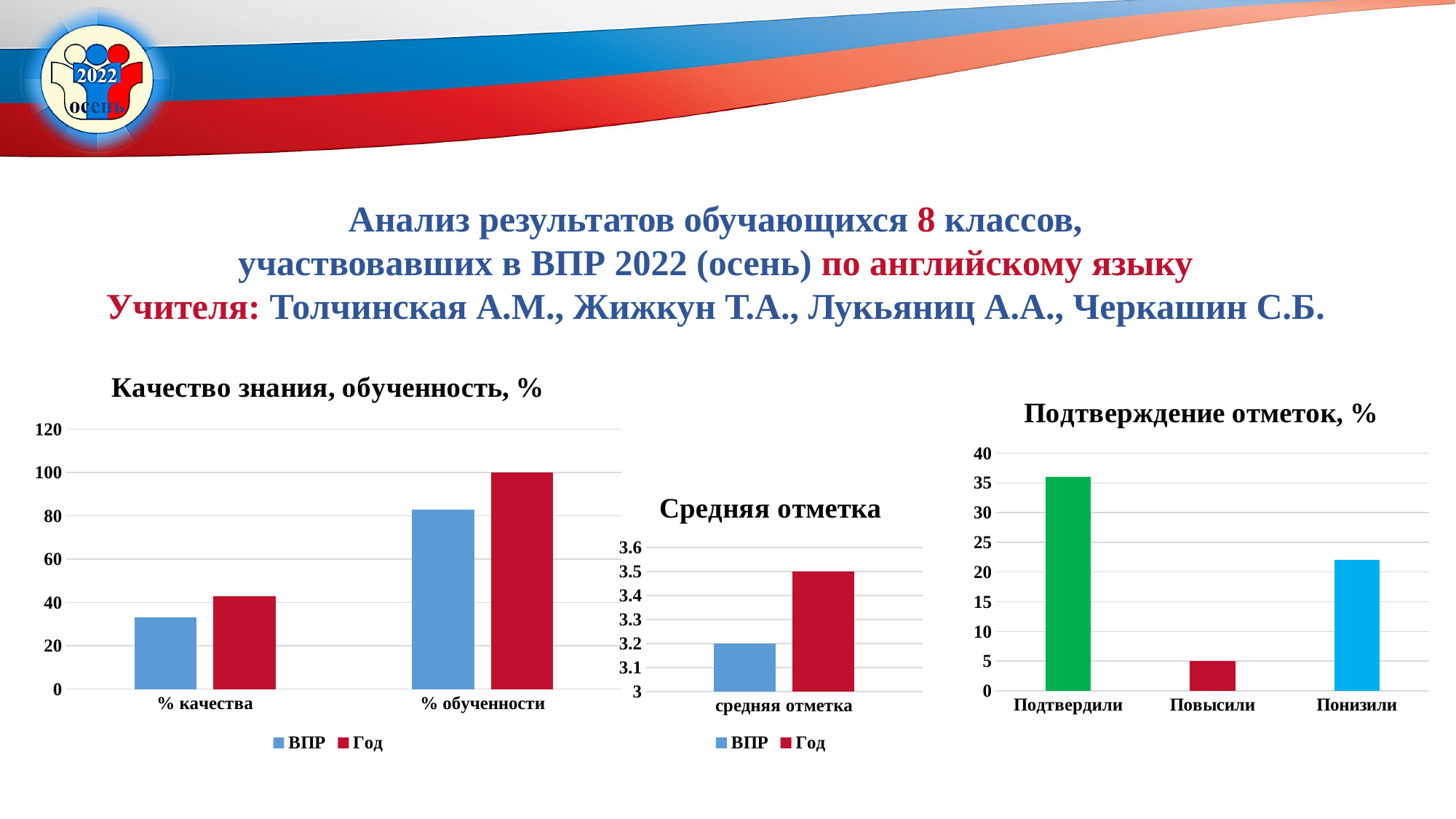
In the chart titled "Подтверждение отметок, %", what is the value for Повысили? 5 In the chart titled "Подтверждение отметок, %", is the value for Понизили greater or less than 20? greater In the chart titled "Подтверждение отметок, %", which category has the lowest value? Повысили In the chart titled "Средняя отметка", what is the value for ВПР? 3.2 In the chart titled "Качество знания, обученность, %", is the ВПР value for % качества greater or less than 40? less What kind of chart is the chart titled "Подтверждение отметок, %"? bar chart In the chart titled "Средняя отметка", what is the difference between the Год value and the ВПР value? 0.3 In the chart titled "Качество знания, обученность, %", which is larger for % качества: ВПР or Год? Год In the chart titled "Подтверждение отметок, %", which category has the highest value? Подтвердили In the chart titled "Качество знания, обученность, %", what is the Год value for % обученности? 100 How many series does the legend list in the chart titled "Качество знания, обученность, %"? 2 In the chart titled "Средняя отметка", what is the value for Год? 3.5